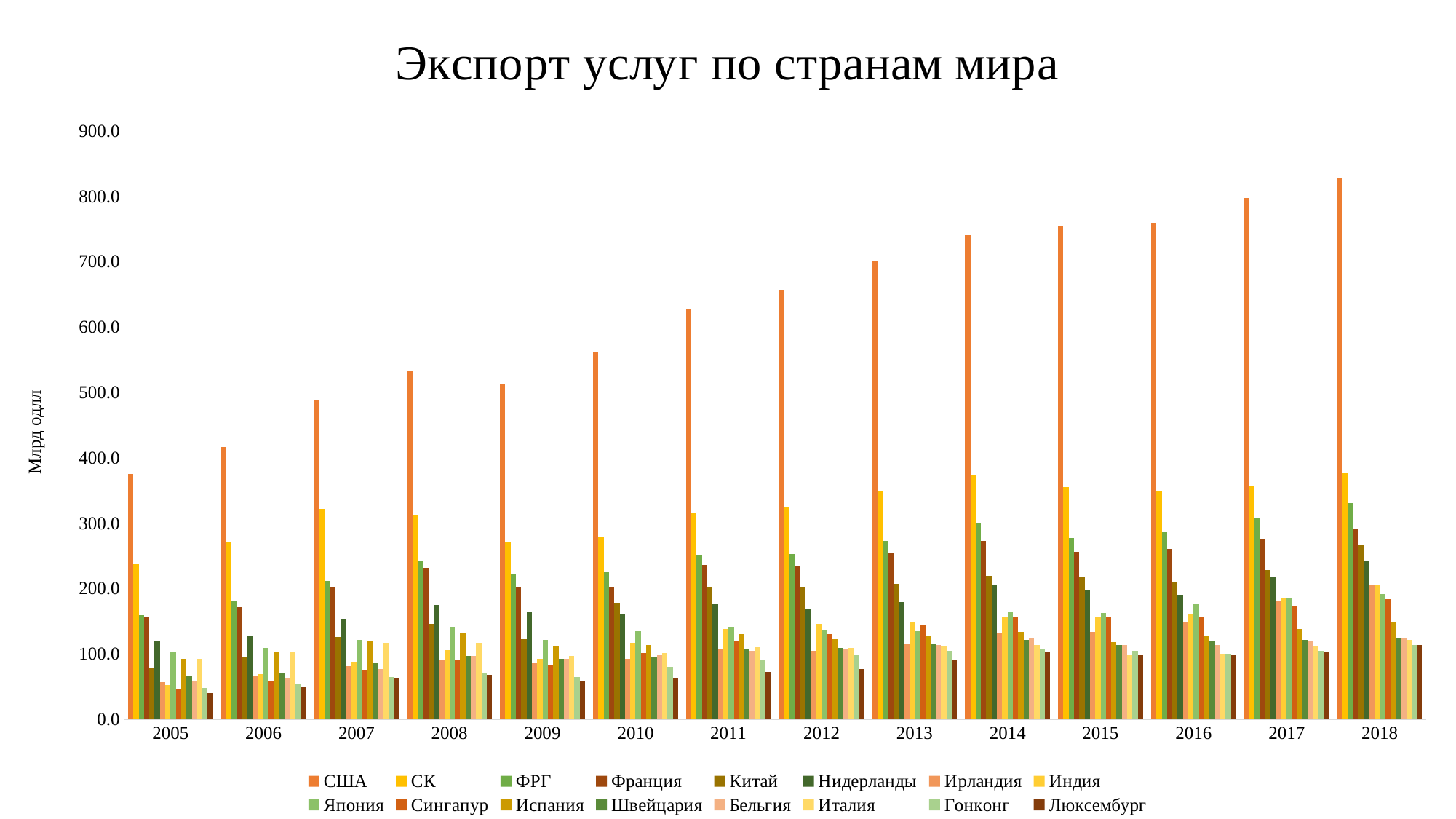
What is the label on the vertical axis? Млрд одлл In which year is the bar for США the highest? 2018 In which year is the bar for США the lowest? 2005 Is the value for США in 2018 greater or less than 800? greater What kind of chart is shown on the slide? bar chart How many series does the legend list? 16 What is the title of the chart? Экспорт услуг по странам мира Do the values for США rise or fall from 2005 to 2018? rise How many years are shown along the x axis? 14 Which country has the highest bar in 2018? США In 2018, which is larger: the value for США or the value for СК? США Is the value for США in 2005 greater or less than 400? less